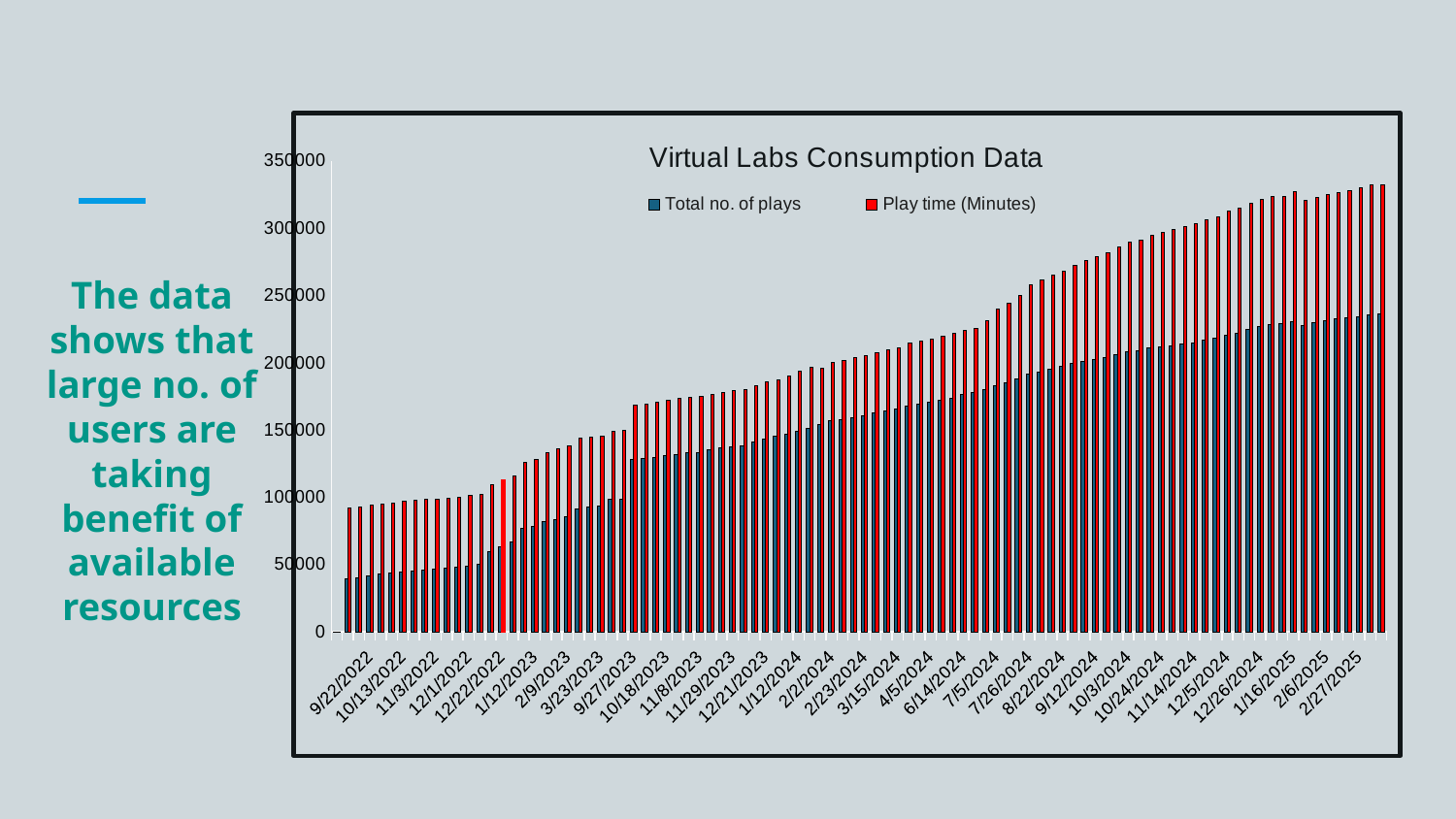
Do the values for Play time (Minutes) rise or fall from 9/22/2022 to 2/27/2025? rise Is the Total no. of plays value for 9/22/2022 greater or less than 50000? less Is the Play time (Minutes) value for 2/27/2025 greater or less than 300000? greater Do the values for Total no. of plays rise or fall along the x axis? rise What kind of chart is shown on the slide? bar chart Is the Total no. of plays value for 2/27/2025 greater or less than 200000? greater How many series does the legend list? 2 Which series is shown in red? Play time (Minutes) For 2/27/2025, which is larger: Total no. of plays or Play time (Minutes)? Play time (Minutes) What is the title of the chart? Virtual Labs Consumption Data